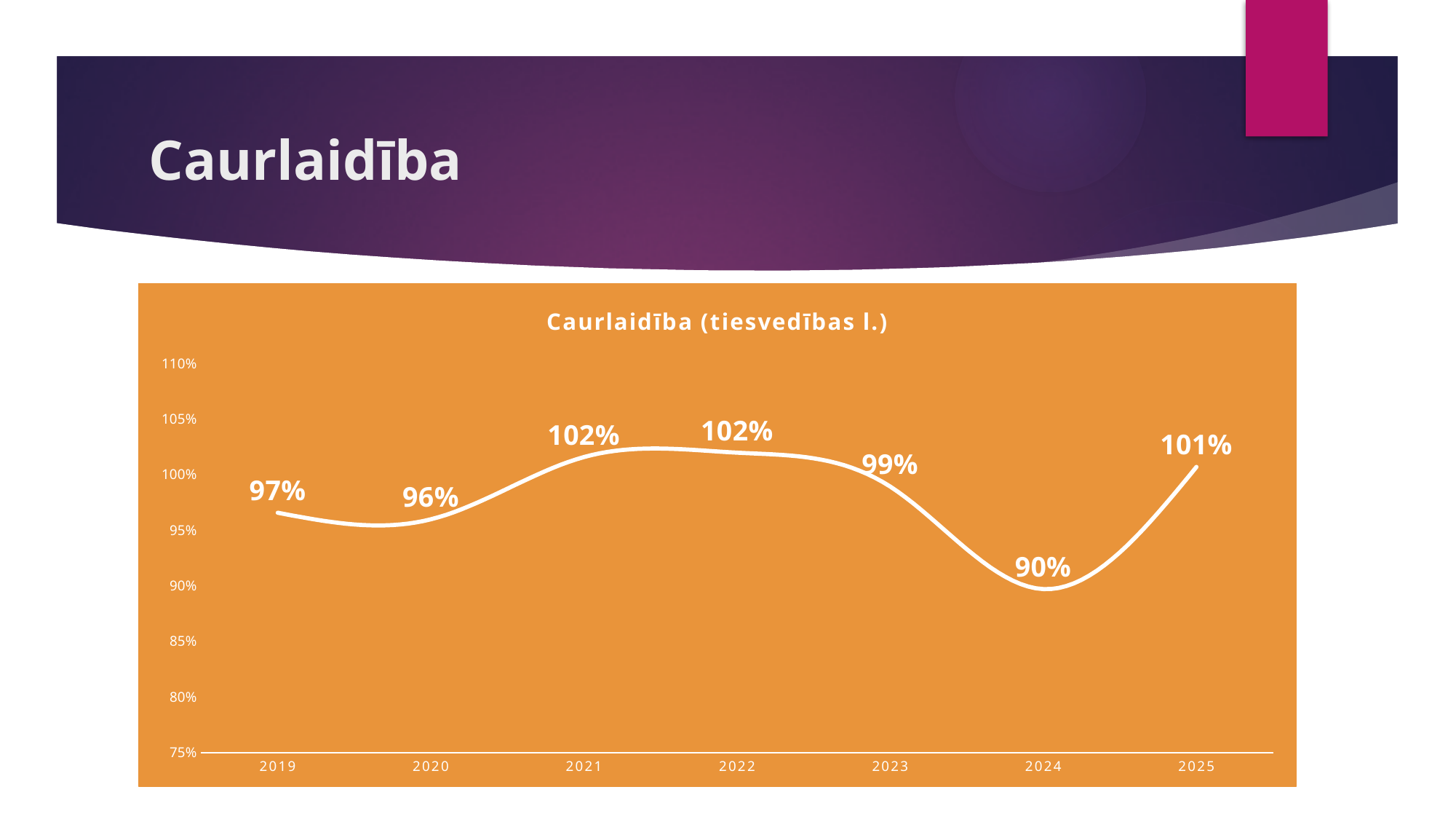
What kind of chart is shown? line chart Which year has the lowest value? 2024 What is the difference between the values for 2025 and 2024? 11% How many years are plotted on the x axis? 7 What is the difference between the values for 2019 and 2020? 1% What is the value for 2024? 90% What is the title of the chart? Caurlaidība (tiesvedības l.) What is the value for 2025? 101% What is the value for 2023? 99% What is the value for 2019? 97% Which is larger, the value for 2023 or the value for 2024? 2023 Is the value for 2021 greater or less than 100%? greater